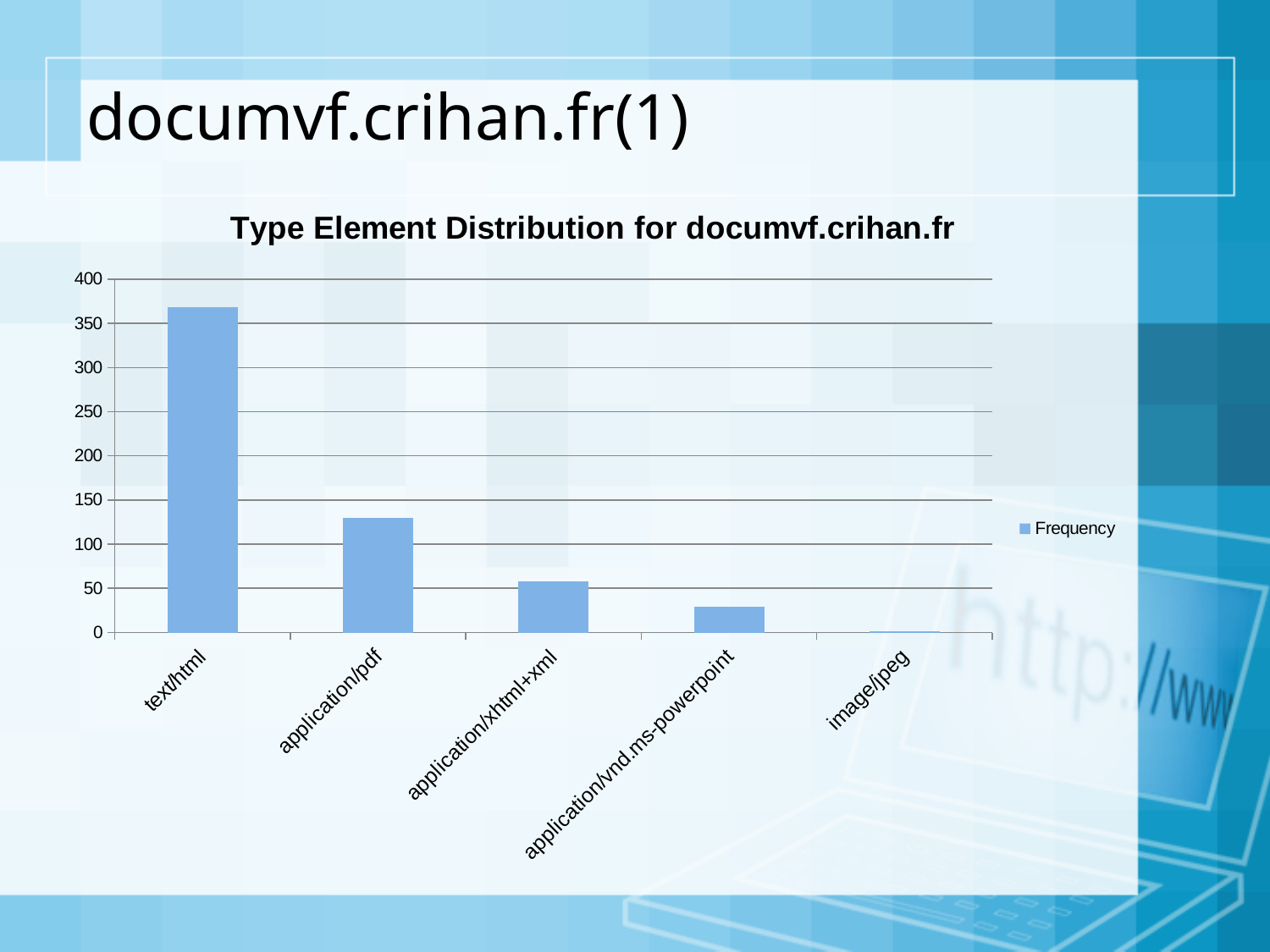
What kind of chart is shown on the slide? bar chart What is the title of the chart? Type Element Distribution for documvf.crihan.fr Which category has the lowest frequency? image/jpeg Is the value for application/pdf greater or less than 150? less Do the frequencies rise or fall moving from left to right along the x axis? fall How many categories are shown on the x axis of the chart? 5 Is the value for application/vnd.ms-powerpoint greater or less than 50? less Is the value for text/html greater or less than 350? greater Which category has the highest frequency? text/html Which has a higher frequency, application/pdf or application/xhtml+xml? application/pdf How many series does the legend list? 1 What is the name of the series shown in the legend? Frequency